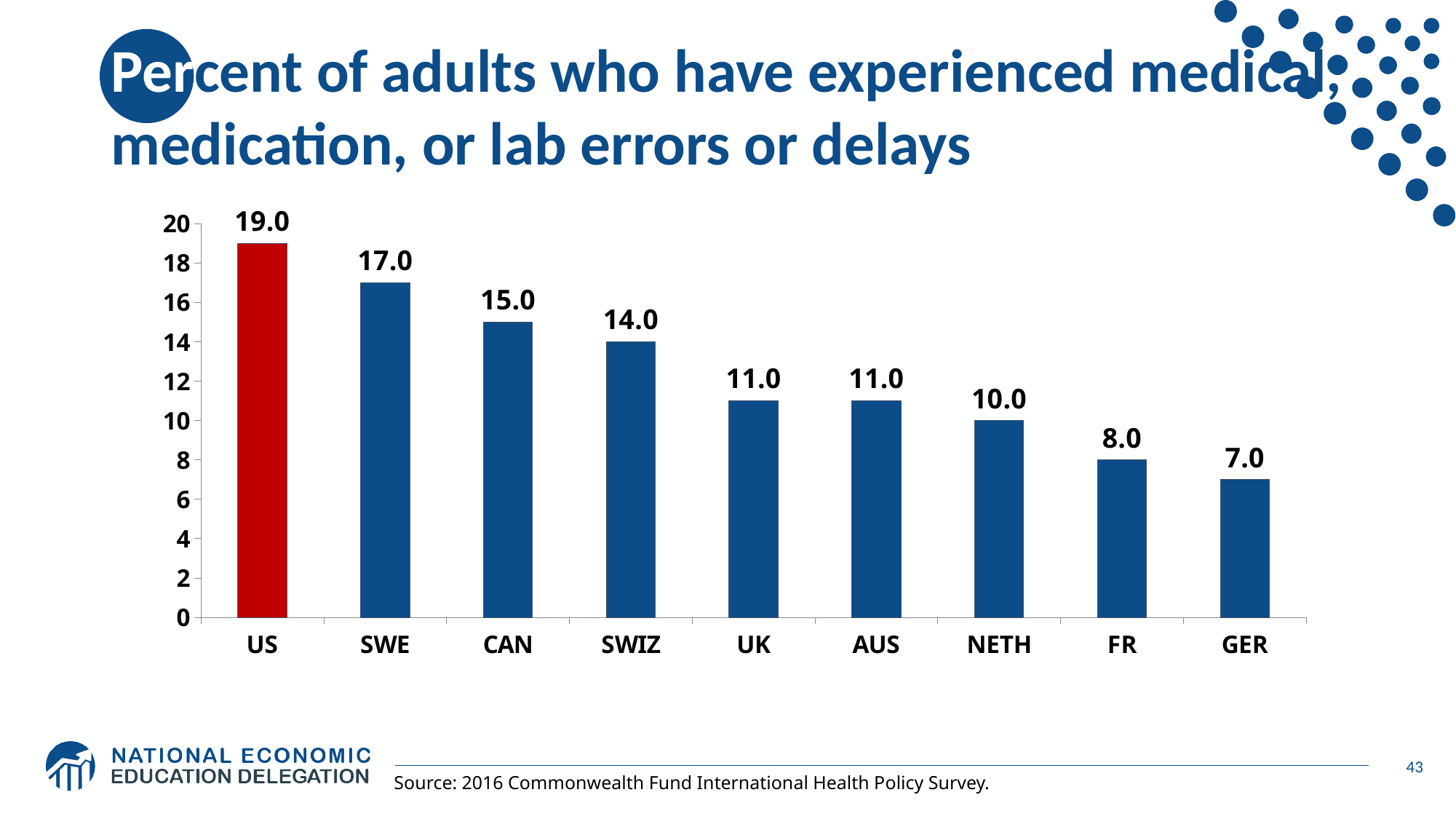
Which country has the lowest value? GER How many countries are shown on the chart? 9 Which bar is coloured red rather than blue? US What is the value for SWIZ? 14.0 What is the difference between the values for SWE and CAN? 2.0 Which is larger, the value for FR or the value for NETH? NETH What is the value for NETH? 10.0 What is the difference between the values for the US and GER? 12.0 What is the value for the US? 19.0 Which country has the highest value? US What kind of chart is shown on the slide? bar chart Is the value for CAN greater or less than 10? greater